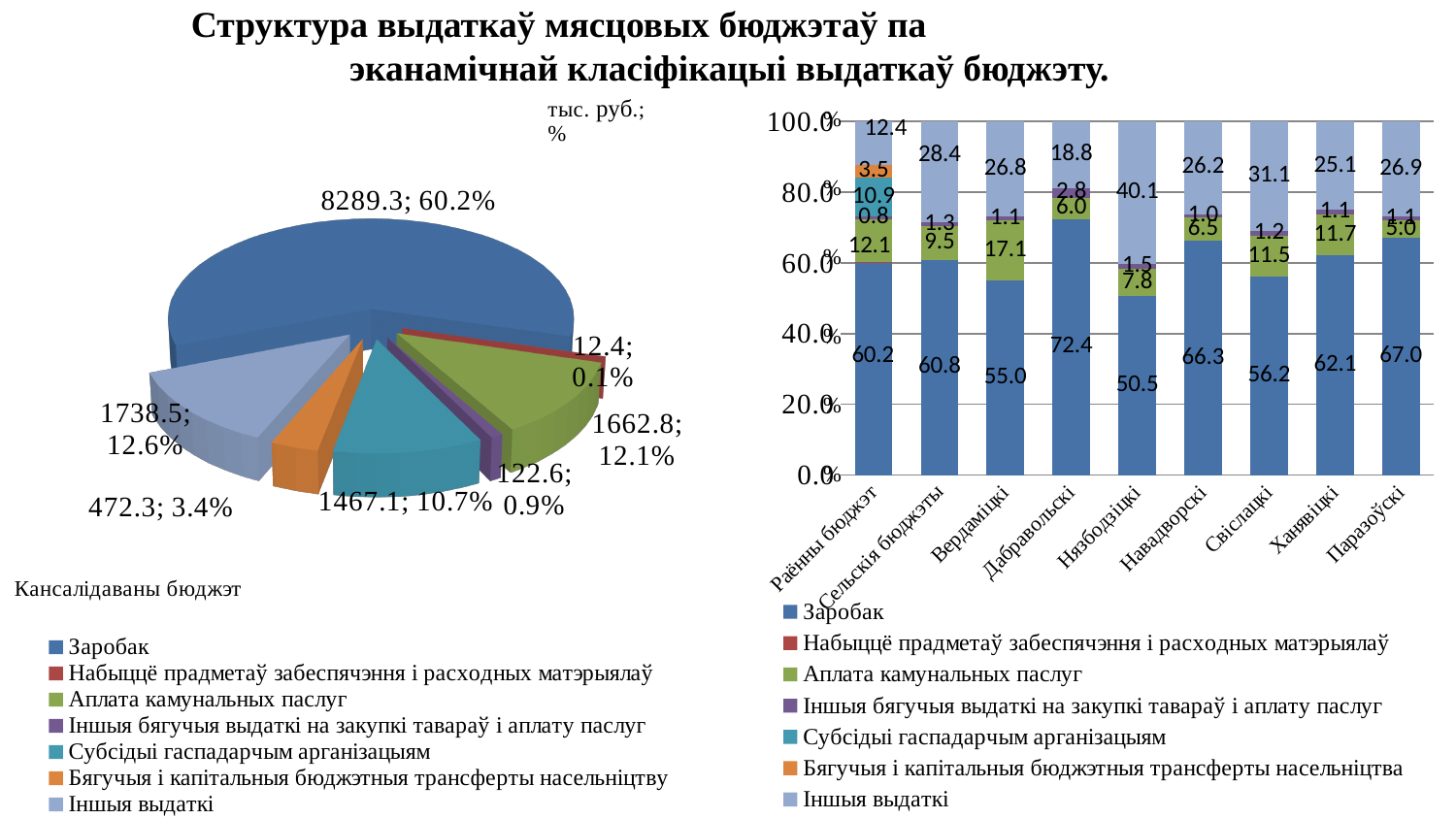
On the stacked bar chart on the right, how many categories are shown on the x axis? 9 On the stacked bar chart on the right, how many series does the legend list? 7 On the pie chart (Кансалідаваны бюджэт), what is the value in тыс. руб. for Аплата камунальных паслуг? 1662.8 On the pie chart (Кансалідаваны бюджэт), what share does Заробак have? 60.2% On the stacked bar chart on the right, which category has the highest Іншыя выдаткі value? Нязбодзіцкі What type of chart is on the right side of the slide? Stacked bar chart On the stacked bar chart on the right, what is the value of Заробак for Дабравольскі? 72.4 On the pie chart (Кансалідаваны бюджэт), which category has the smallest slice? Набыццё прадметаў забеспячэння і расходных матэрыялаў On the pie chart (Кансалідаваны бюджэт), how many slices are there? 7 On the stacked bar chart on the right, which is larger: Аплата камунальных паслуг for Вердаміцкі or for Паразоўскі? Вердаміцкі On the stacked bar chart on the right, which category has the lowest Заробак value? Нязбодзіцкі On the pie chart (Кансалідаваны бюджэт), what is the difference in тыс. руб. between Іншыя выдаткі and Субсідыі гаспадарчым арганізацыям? 271.4